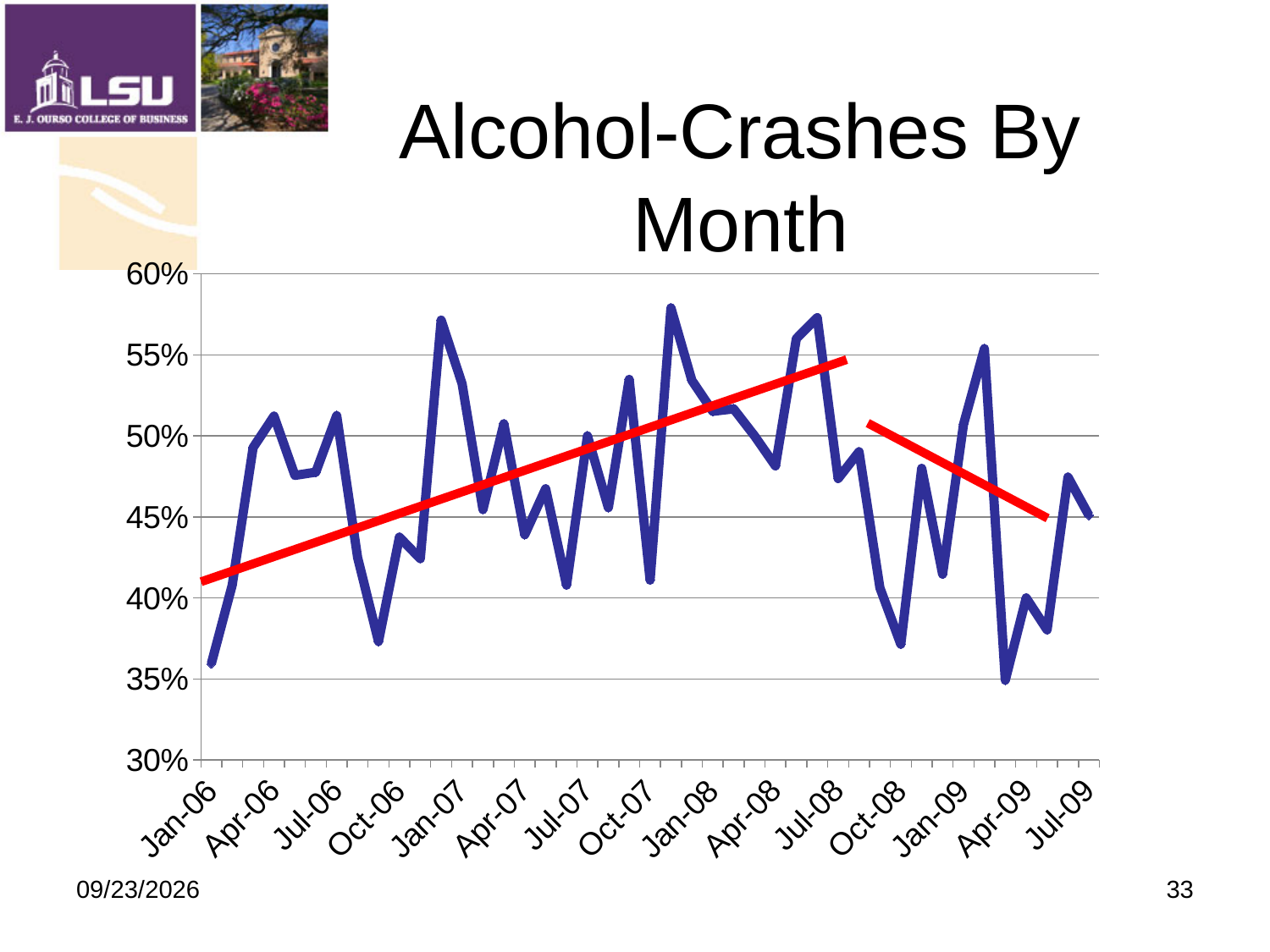
How many red trend lines are drawn over the data line? 2 Is the value for Oct-07 greater or less than 50%? less According to the first red trend line (Jan-06 to Jul-08), do the values rise or fall over time? rise Is the value for Jul-07 greater or less than 45%? greater Is the value for Oct-06 greater or less than 40%? greater What is the title of the chart? Alcohol-Crashes By Month What kind of chart is shown on the slide? line chart Which is larger, the value for Jan-06 or the value for Jan-07? Jan-07